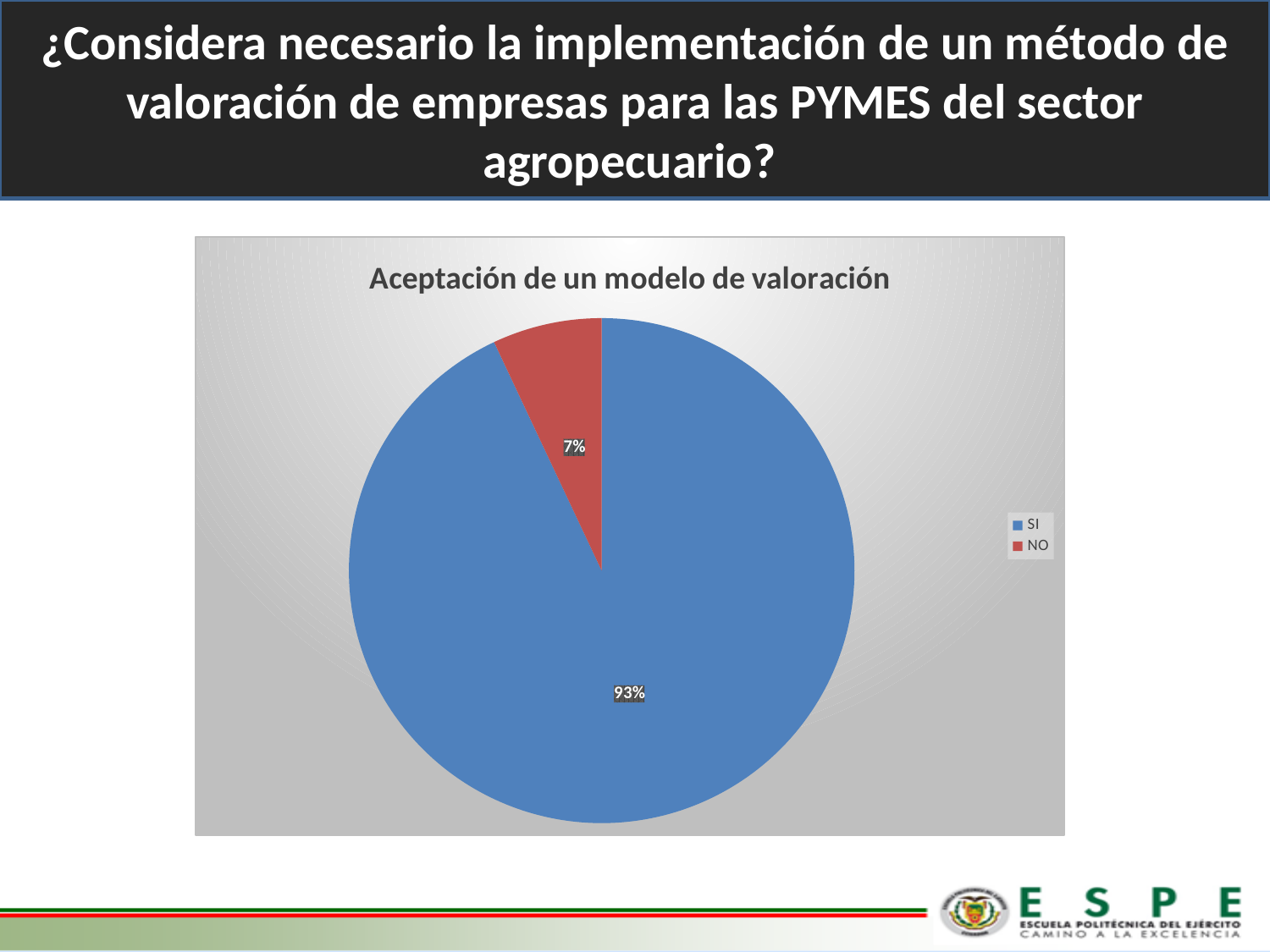
How many categories does the pie chart have? 2 How many entries does the legend list? 2 What share of the pie does NO represent? 7% What colour is the SI slice? blue Which category has the smallest slice? NO Which category has the largest slice? SI What share of the pie does SI represent? 93% What is the chart's title? Aceptación de un modelo de valoración What kind of chart is shown on the slide? pie chart What is the difference in percentage points between SI and NO? 86 Which is larger, the SI slice or the NO slice? SI